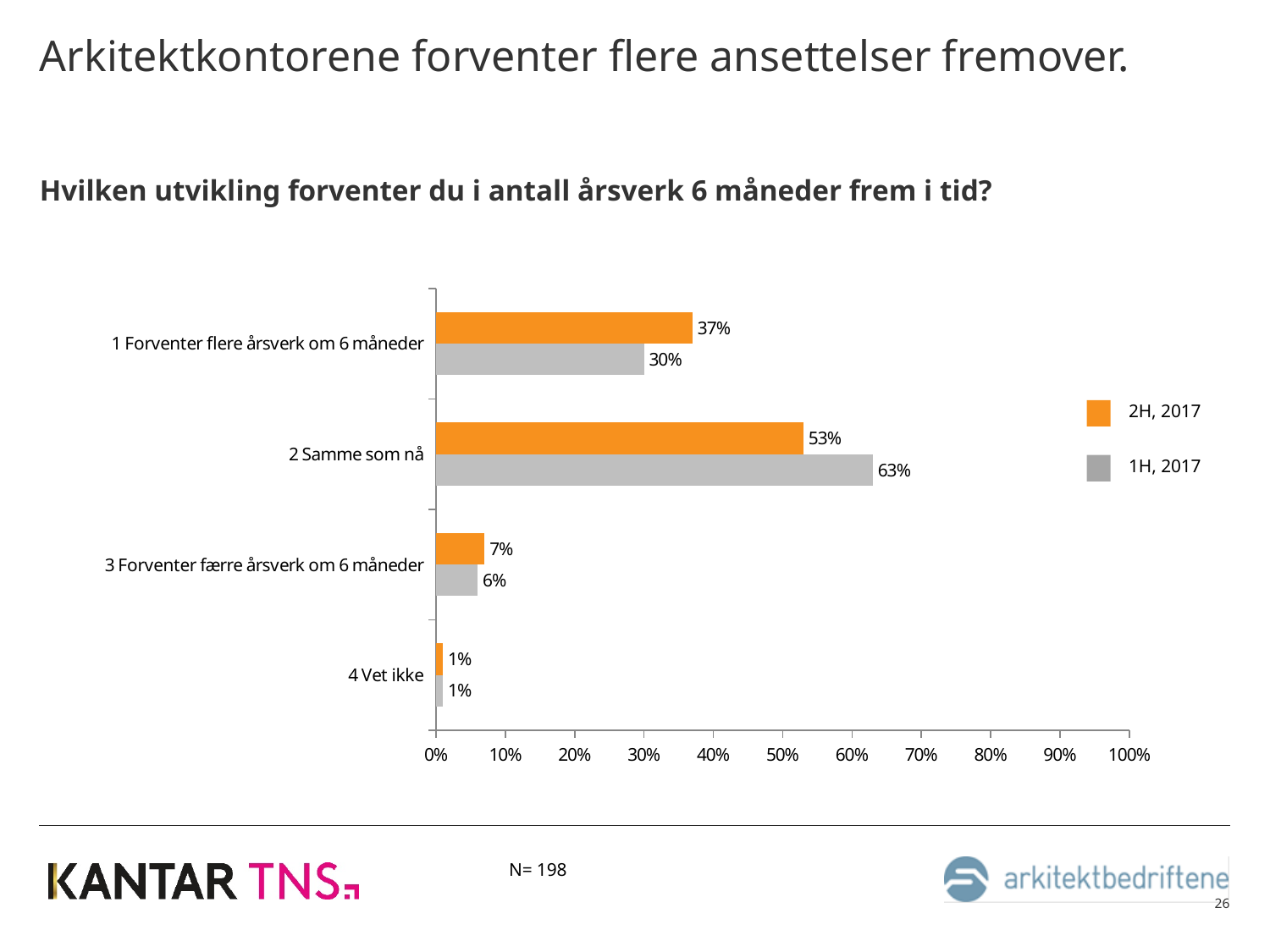
What is the value for '2 Samme som nå' in the 1H, 2017 series? 63% What is the difference between the 2H, 2017 and 1H, 2017 values for '1 Forventer flere årsverk om 6 måneder'? 7% What kind of chart is shown on the slide? Bar chart What is the value for '3 Forventer færre årsverk om 6 måneder' in the 1H, 2017 series? 6% What is the difference between the 1H, 2017 and 2H, 2017 values for '2 Samme som nå'? 10% Which category has the highest value in the 2H, 2017 series? 2 Samme som nå How many categories are shown on the chart? 4 What is the value for '1 Forventer flere årsverk om 6 måneder' in the 2H, 2017 series? 37% For '1 Forventer flere årsverk om 6 måneder', which series has the larger value, 2H, 2017 or 1H, 2017? 2H, 2017 Which category has the lowest value in the 1H, 2017 series? 4 Vet ikke Is the 1H, 2017 value for '2 Samme som nå' greater or less than 60%? greater How many series does the legend list? 2